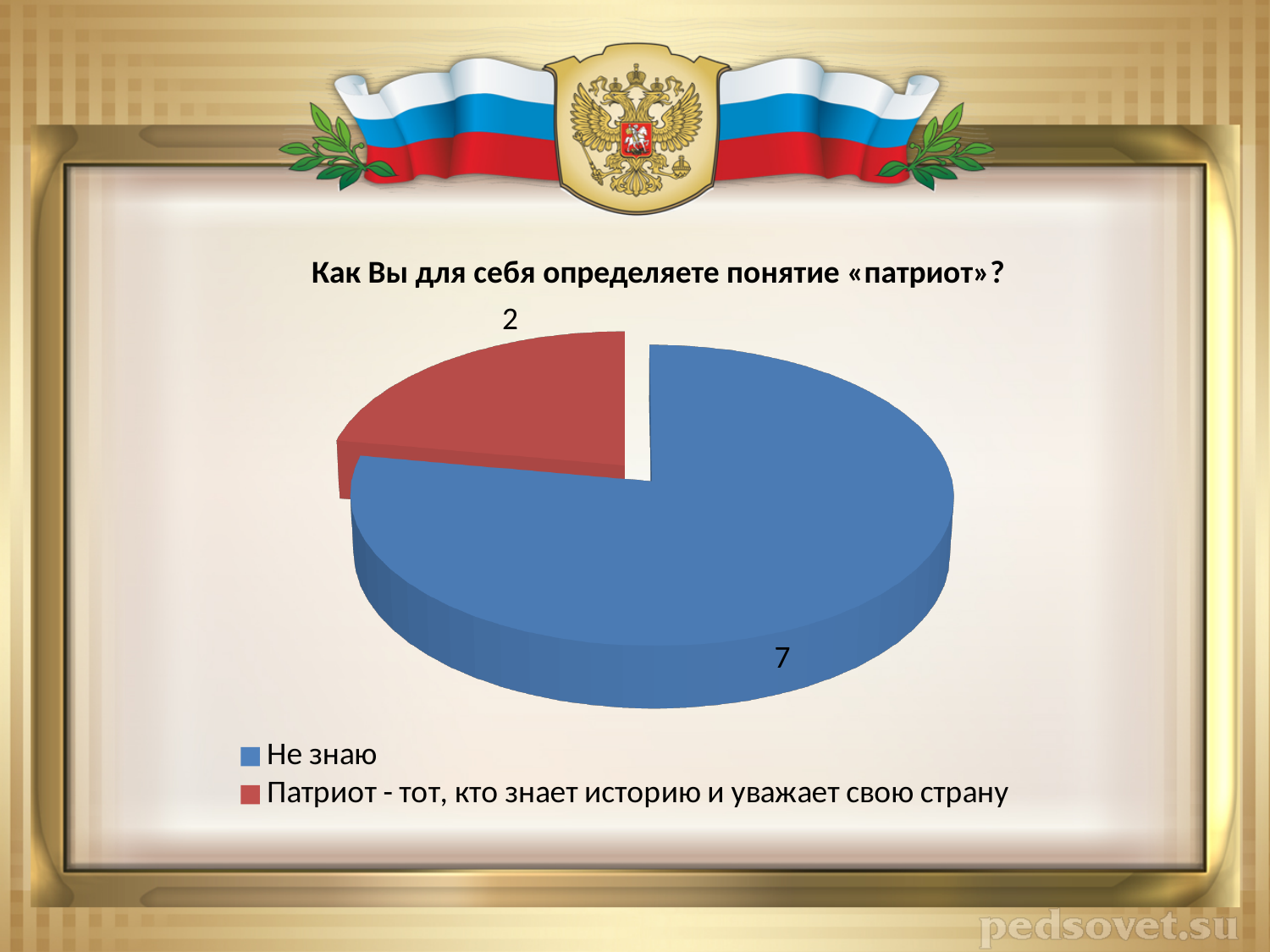
Which category has the smallest slice of the pie? Патриот - тот, кто знает историю и уважает свою страну Which category has the largest slice of the pie? Не знаю What is the value for the slice "Не знаю"? 7 What is the difference between the values for "Не знаю" and "Патриот - тот, кто знает историю и уважает свою страну"? 5 What colour is the slice for "Не знаю"? blue What is the total of all slice values in the pie chart? 9 How many entries does the legend list? 2 What is the title of the chart? Как Вы для себя определяете понятие «патриот»? Which is larger: the value for "Не знаю" or the value for "Патриот - тот, кто знает историю и уважает свою страну"? Не знаю What is the value for the slice "Патриот - тот, кто знает историю и уважает свою страну"? 2 What type of chart is shown on the slide? pie chart How many slices does the pie chart have? 2